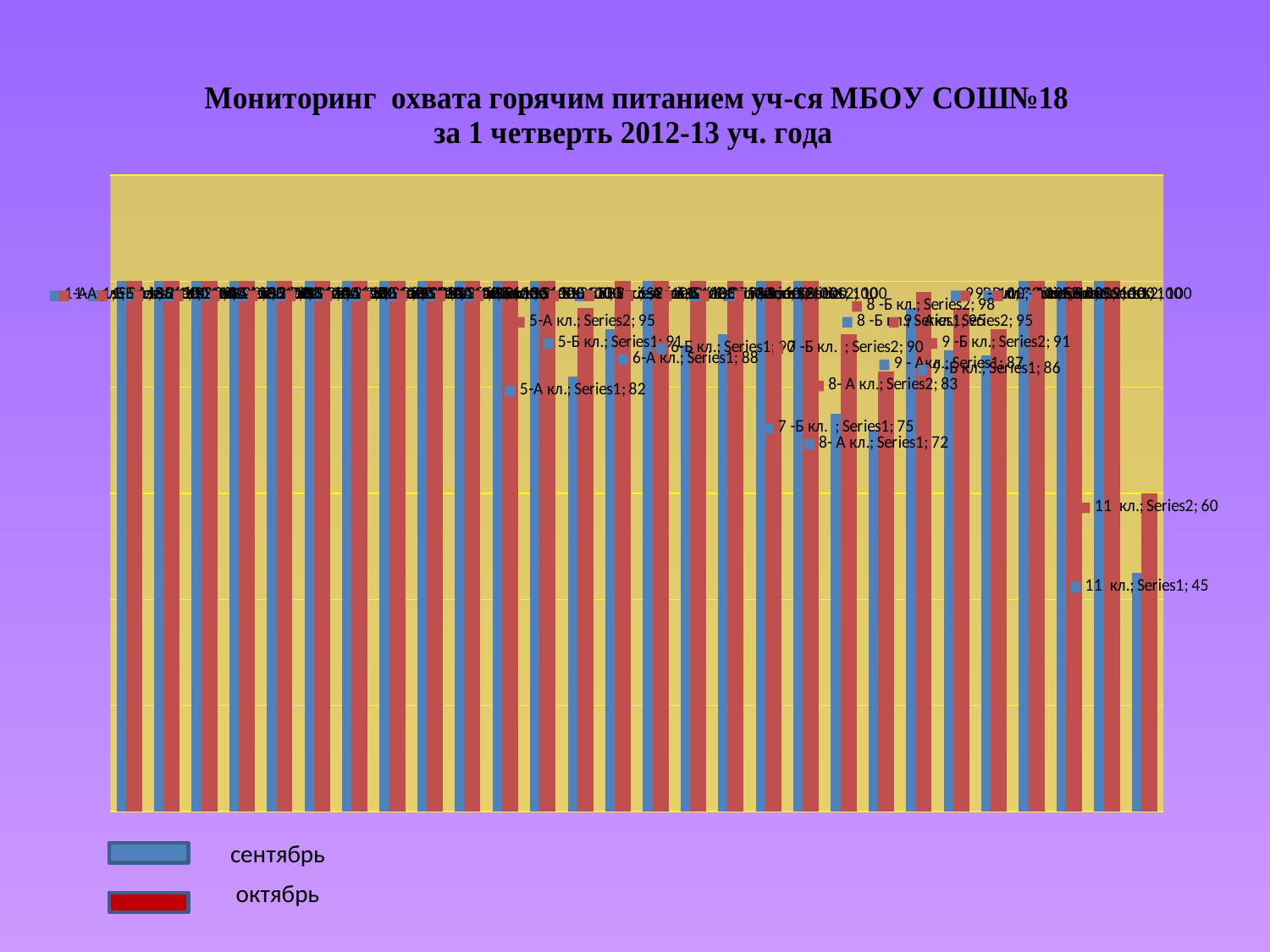
What is the Series1 value for 5-А кл.? 82 What is the Series2 (октябрь) value for 11 кл.? 60 What is the difference between the Series2 and Series1 values for 11 кл.? 15 Which bar has the lowest value on the chart? 11 кл., Series1 (45) What is the Series1 value for 8-А кл.? 72 What is the Series2 value for 8-Б кл.? 98 What is the Series1 (сентябрь) value for 11 кл.? 45 What is the Series2 value for 9-Б кл.? 91 What kind of chart is shown on the slide? Bar chart For 11 кл., which is larger: the Series1 value or the Series2 value? Series2 What is the Series1 value for 7-Б кл.? 75 How many series does the legend list? 2